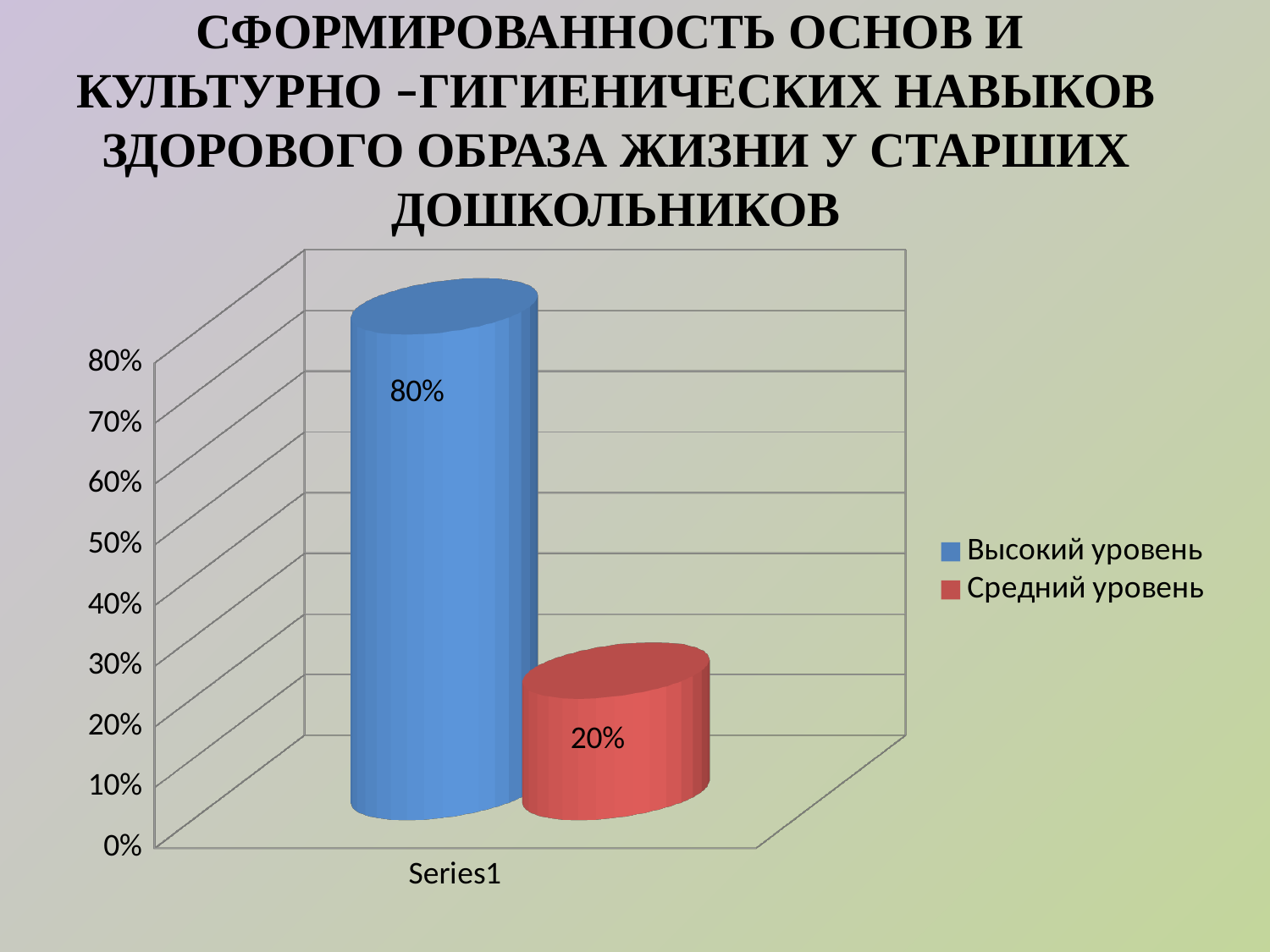
What colour is the bar for Средний уровень? red What is the category label shown on the x axis? Series1 What kind of chart is shown on the slide? bar chart Is the value for Средний уровень greater or less than 30%? less How many series does the legend list? 2 What value is shown for Средний уровень? 20% What value is shown for Высокий уровень? 80% Which series has the lowest value? Средний уровень Which series has the highest value? Высокий уровень What is the difference between the values for Высокий уровень and Средний уровень? 60% Is the value for Высокий уровень greater or less than 50%? greater Which is larger, the value for Высокий уровень or the value for Средний уровень? Высокий уровень